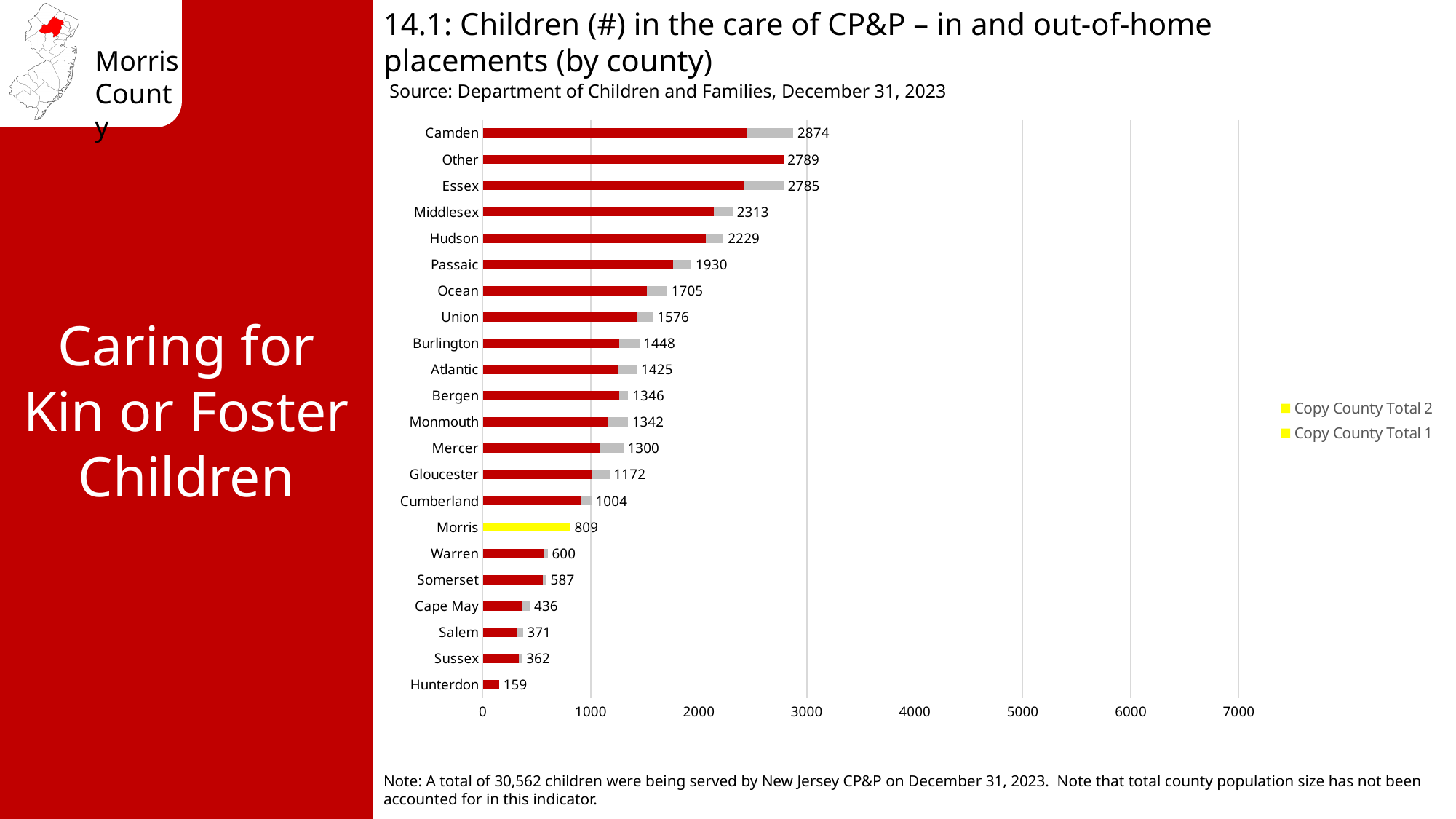
How many series does the legend list? 2 What kind of chart is shown on the slide? bar chart What is the total number of children in the care of CP&P for Camden? 2874 How many counties/categories are shown on the chart? 22 What is the difference between the values for Camden and Essex? 89 What is the difference between the values for Morris and Warren? 209 Which has a larger value, Ocean or Union? Ocean Which county has the lowest value on the chart? Hunterdon Which county has the highest value on the chart? Camden What is the value shown for Passaic? 1930 What is the value shown for Morris? 809 Is the value for Cumberland greater or less than 2000? less